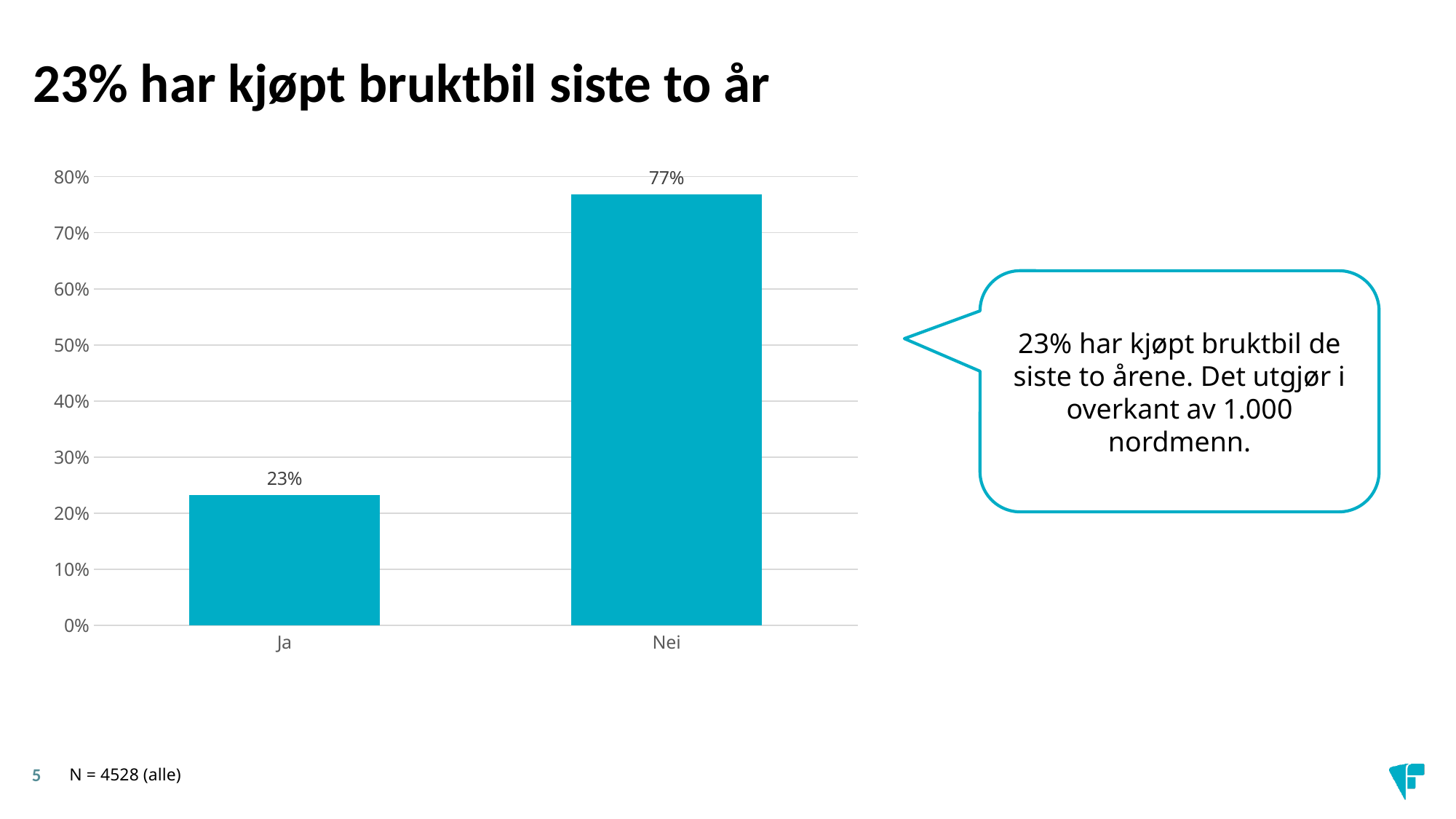
What is the value for Nei? 77% Which is larger, the value for Ja or the value for Nei? Nei Is the value for Ja greater or less than 30%? less What is the total of the two bar values? 100% What is the value for Ja? 23% What is the highest value shown on the y axis? 80% Is the value for Nei greater or less than 70%? greater What is the difference between the values for Nei and Ja? 54% What kind of chart is shown on the slide? bar chart How many categories are shown on the x axis? 2 Which category has the highest value? Nei Which category has the lowest value? Ja